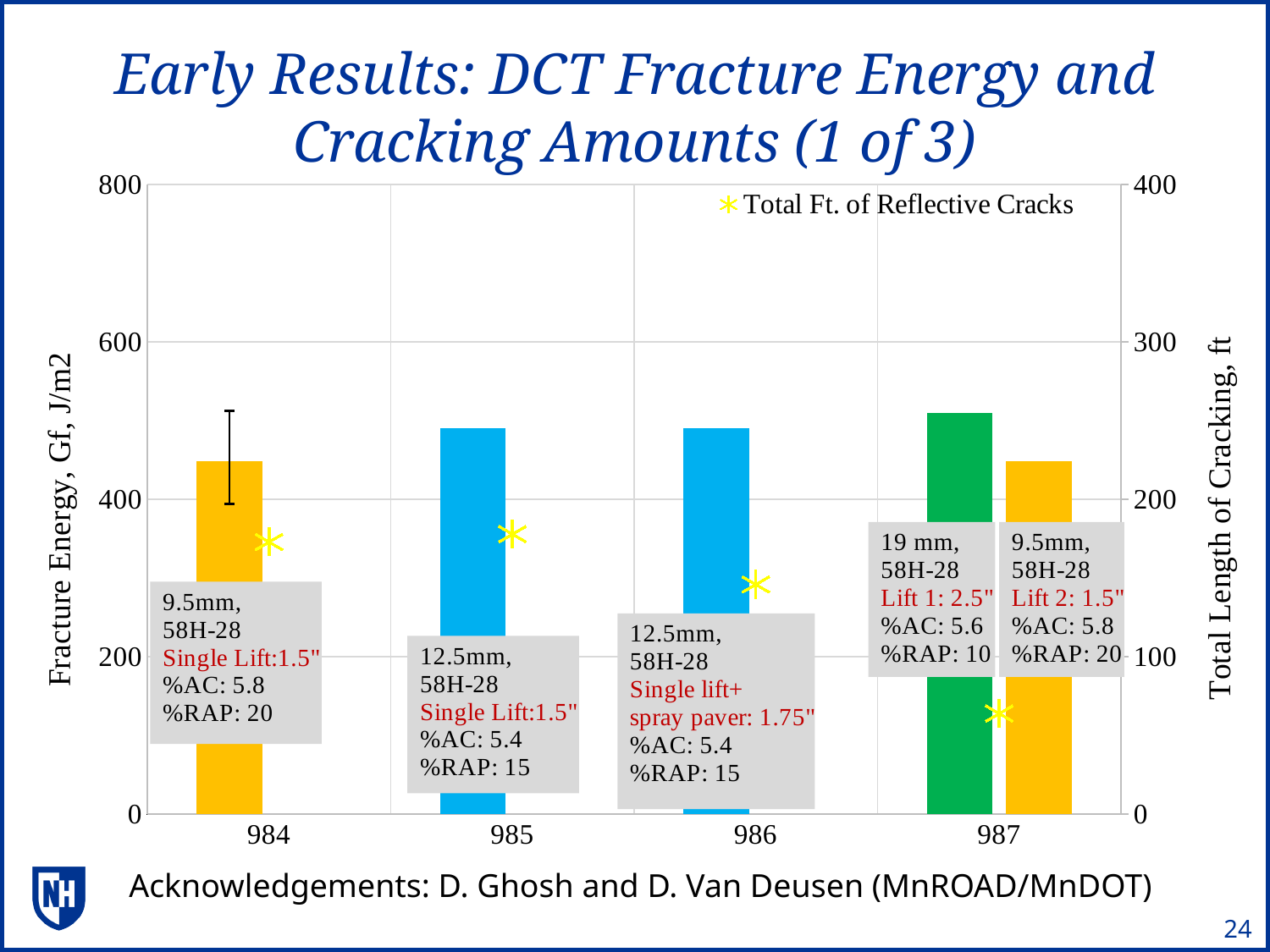
Is the Total Ft. of Reflective Cracks marker for 984 greater or less than 100 ft on the right axis? greater Which is larger, the fracture energy bar for 984 or the fracture energy bar for 985? 985 Is the green fracture energy bar for 987 greater or less than 400 J/m2? greater Is the fracture energy bar for 984 greater or less than 400 J/m2? greater Which category has the lowest Total Ft. of Reflective Cracks marker? 987 What is the title of the left vertical axis of the chart? Fracture Energy, Gf, J/m2 What is the title of the right vertical axis of the chart? Total Length of Cracking, ft Which is larger, the Total Ft. of Reflective Cracks marker for 984 or for 986? 984 How many categories are shown on the x axis of the chart? 4 What kind of chart is shown on the slide? bar chart